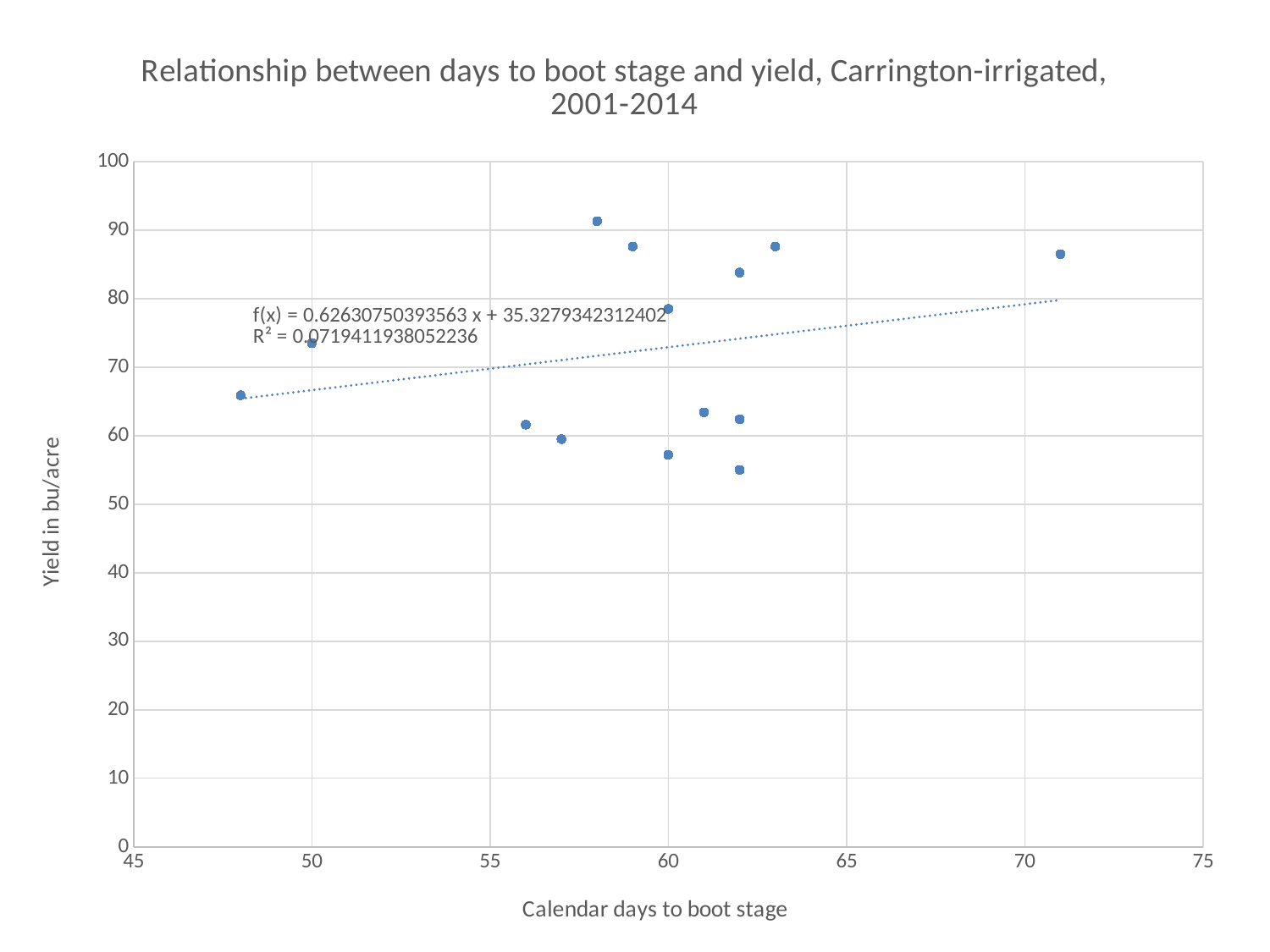
Which has the higher yield: the point at 48 calendar days to boot stage or the point at 50 calendar days to boot stage? the point at 50 days Is the yield for the point at 63 calendar days to boot stage greater or less than 80? greater At how many calendar days to boot stage does the point with the lowest yield occur? 62 What is the R² value shown for the trendline? 0.0719411938052236 Is the yield for the point at 71 calendar days to boot stage greater or less than 80? greater Is the yield for the point at 48 calendar days to boot stage greater or less than 70? less At how many calendar days to boot stage does the point with the highest yield occur? 58 Does the dotted trendline rise or fall as calendar days to boot stage increase? rise What is the title of the chart? Relationship between days to boot stage and yield, Carrington-irrigated, 2001-2014 What kind of chart is shown on the slide? scatter chart How many data points are plotted on the chart? 14